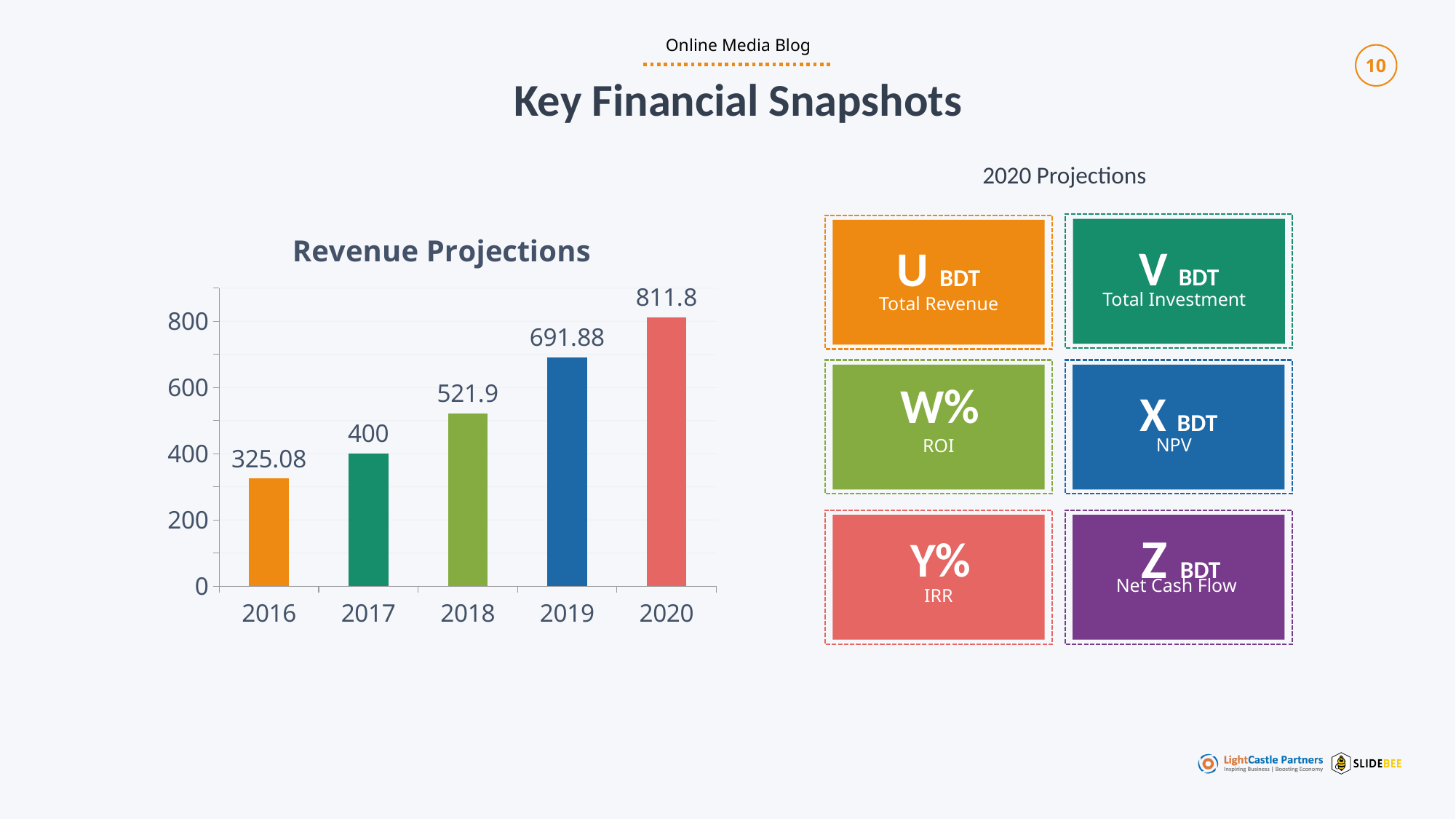
What is the revenue projection value for 2016? 325.08 What kind of chart is the Revenue Projections chart? bar chart What is the revenue projection value for 2020? 811.8 What is the title of the chart on the slide? Revenue Projections What is the difference between the revenue projections for 2019 and 2017? 291.88 How many years are shown on the x axis of the Revenue Projections chart? 5 Do the revenue projections rise or fall from 2016 to 2020? rise What is the revenue projection value for 2018? 521.9 Which year has the lowest revenue projection? 2016 Which year has a larger revenue projection, 2018 or 2019? 2019 Which year has the highest revenue projection? 2020 Is the revenue projection for 2017 greater or less than 600? less